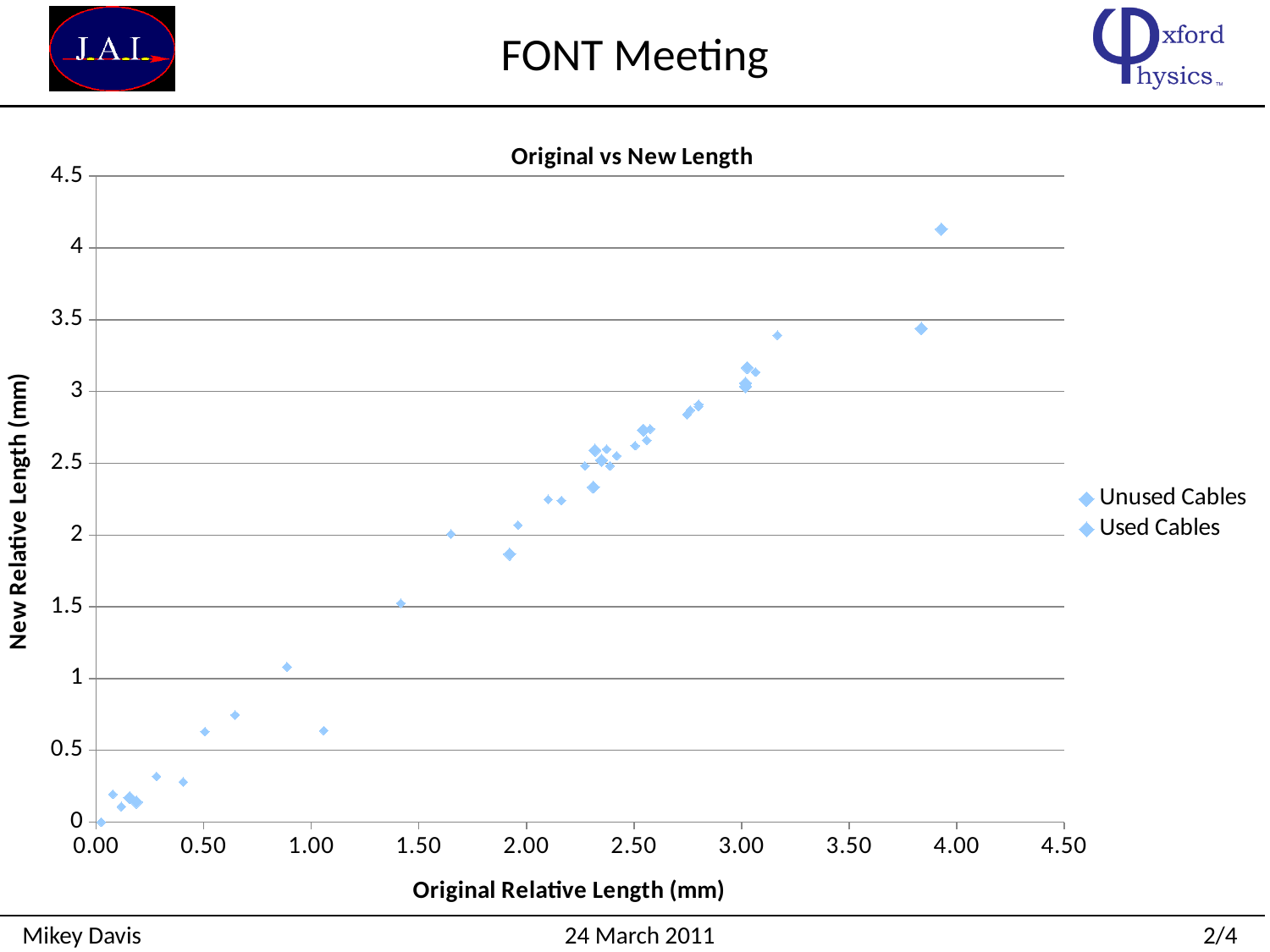
Is the y value of the lowest point on the chart greater or less than 0.5? less Do the plotted values rise or fall as the original relative length increases along the x axis? rise Is the y value of the highest point on the chart greater or less than 4? greater What kind of chart is shown on the slide? scatter chart How many series does the legend list? 2 Is the x value of the rightmost point on the chart greater or less than 3.50? greater What are the two entries in the chart's legend? Unused Cables, Used Cables What is the title of the chart? Original vs New Length